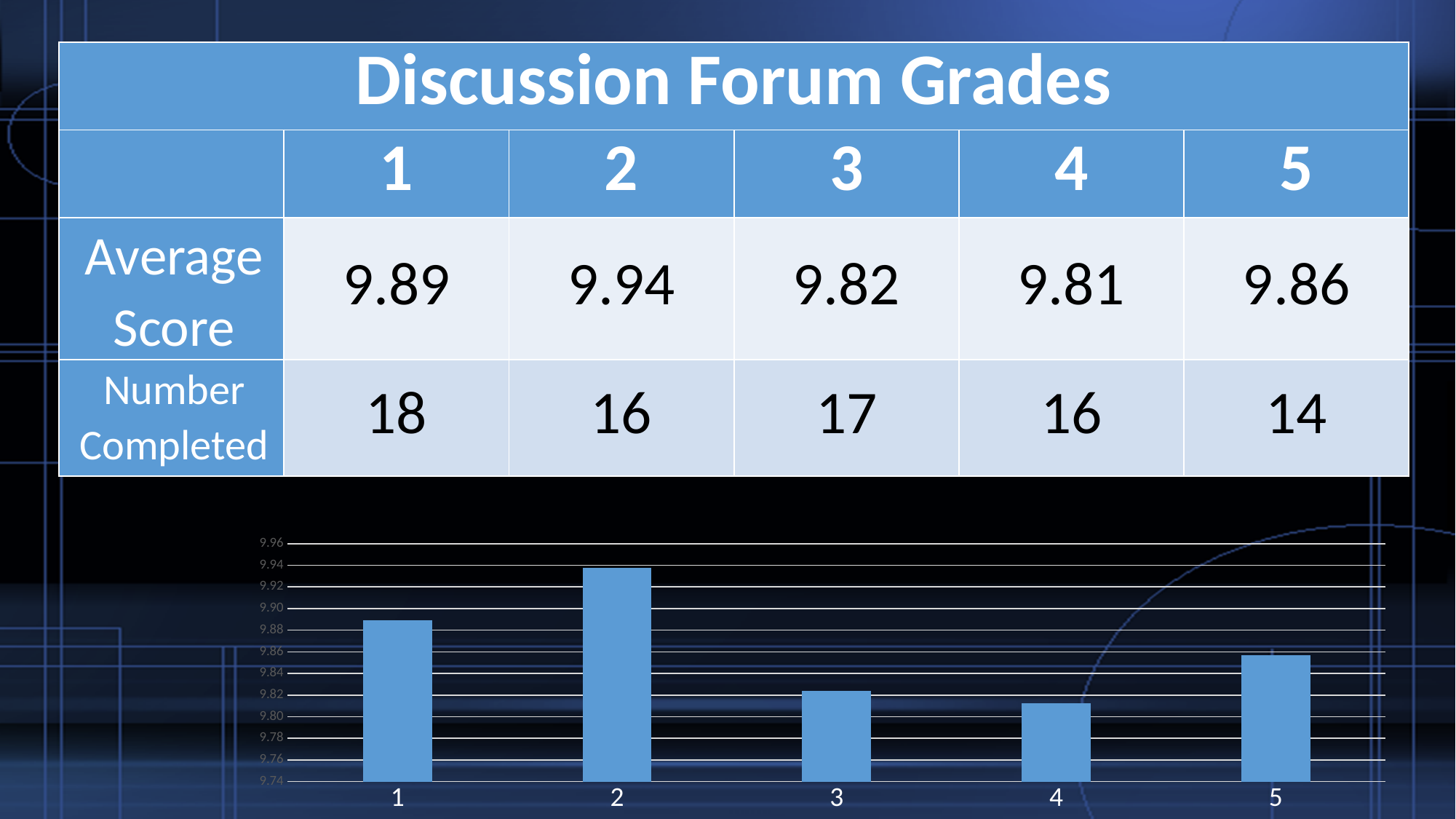
Which bar is taller, category 1 or category 5? 1 How many bars does the chart show? 5 What is the average score plotted for category 2? 9.94 Which category has the tallest bar in the chart? 2 Is the bar for category 2 greater or less than 9.90? greater What is the average score plotted for category 5? 9.86 Which bar is taller, category 3 or category 2? 2 What is the difference between the average scores for category 2 and category 4? 0.13 Is the bar for category 4 greater or less than 9.84? less What is the lowest value shown on the chart's vertical axis? 9.74 Is the bar for category 1 greater or less than 9.86? greater What kind of chart is shown at the bottom of the slide? bar chart